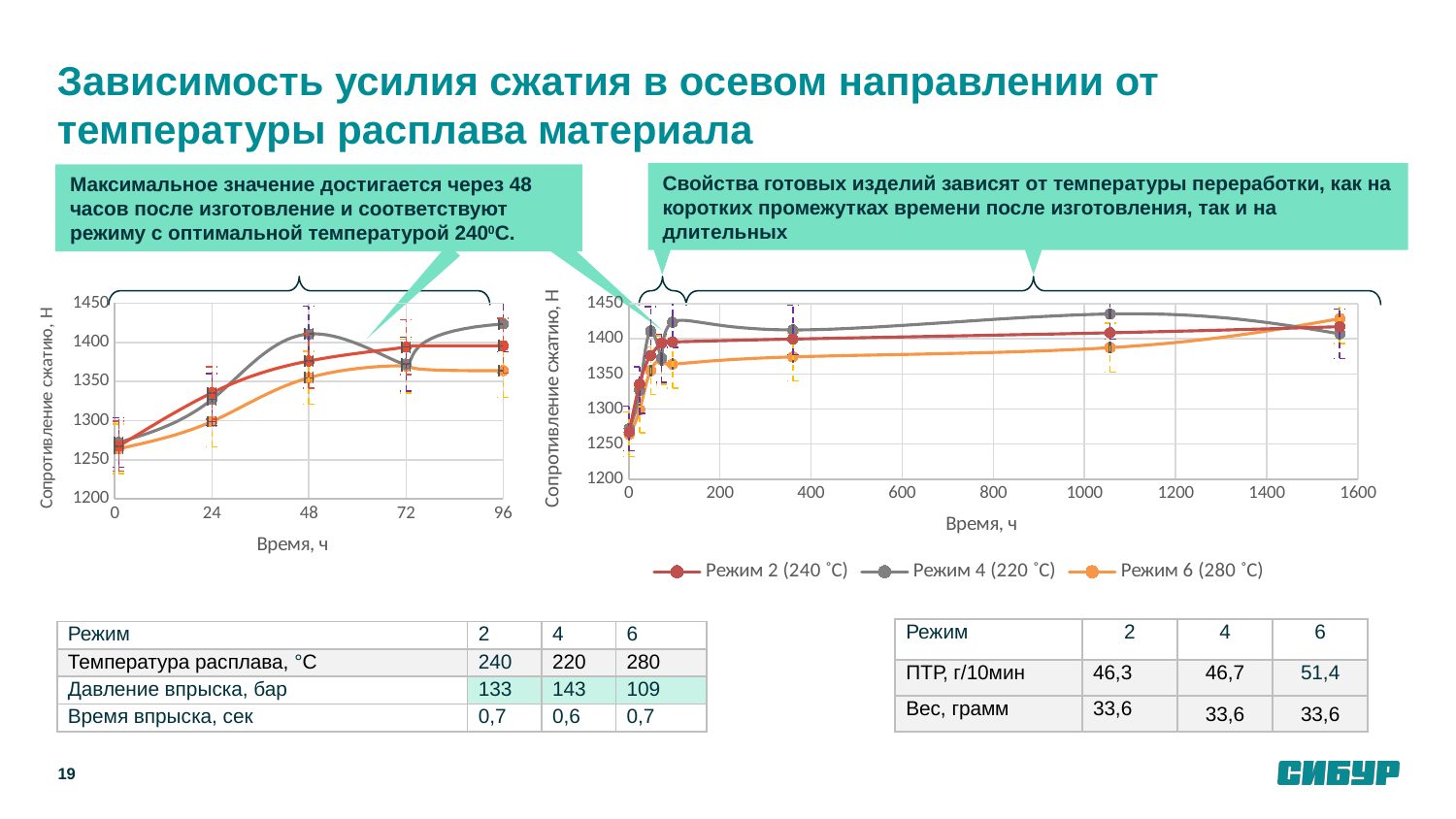
What is the y-axis title of the charts? Сопротивление сжатию, Н What kind of chart is the left chart (time axis 0–96 h)? Line chart On the left chart (time axis 0–96 h), which is larger at 96 h: Режим 4 (220 °C) or Режим 6 (280 °C)? Режим 4 (220 °C) On the right chart (time axis 0–1600 h), which is larger at about 1050 h: Режим 4 (220 °C) or Режим 6 (280 °C)? Режим 4 (220 °C) On the left chart (time axis 0–96 h), is the value for Режим 2 (240 °C) at 0 h greater or less than 1300? less How many series does the legend list for the charts? 3 Which series are listed in the legend? Режим 2 (240 °C), Режим 4 (220 °C), Режим 6 (280 °C) On the left chart (time axis 0–96 h), is the value for Режим 4 (220 °C) at 48 h greater or less than 1400? greater On the left chart (time axis 0–96 h), is the value for Режим 6 (280 °C) at 96 h greater or less than 1400? less On the left chart (time axis 0–96 h), how many time points are plotted for each series? 5 On the left chart (time axis 0–96 h), do the values for Режим 2 (240 °C) generally rise or fall from 0 h to 96 h? rise